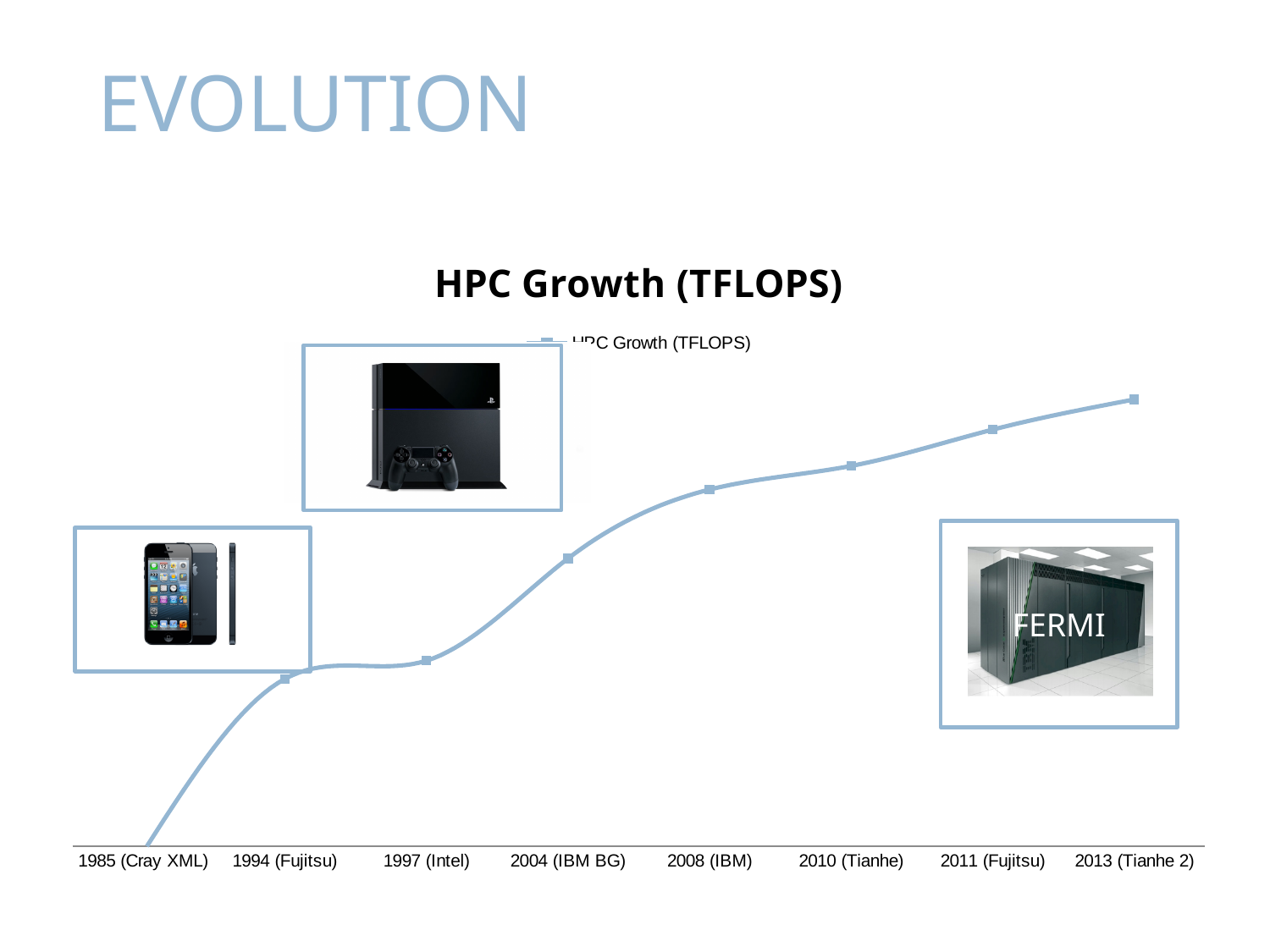
Do the values rise or fall along the x axis from 1985 (Cray XML) to 2013 (Tianhe 2)? rise How many series does the chart's legend list? 1 Which category has the highest value in the chart? 2013 (Tianhe 2) Which has the larger value, 1994 (Fujitsu) or 2008 (IBM)? 2008 (IBM) Which has the larger value, 2004 (IBM BG) or 1997 (Intel)? 2004 (IBM BG) How many categories are shown on the x axis of the chart? 8 What is the first category on the x axis of the chart? 1985 (Cray XML) Which category has the lowest value in the chart? 1985 (Cray XML) What kind of chart is shown on the slide? line chart What is the title of the chart? HPC Growth (TFLOPS) Which has the larger value, 2011 (Fujitsu) or 2010 (Tianhe)? 2011 (Fujitsu)